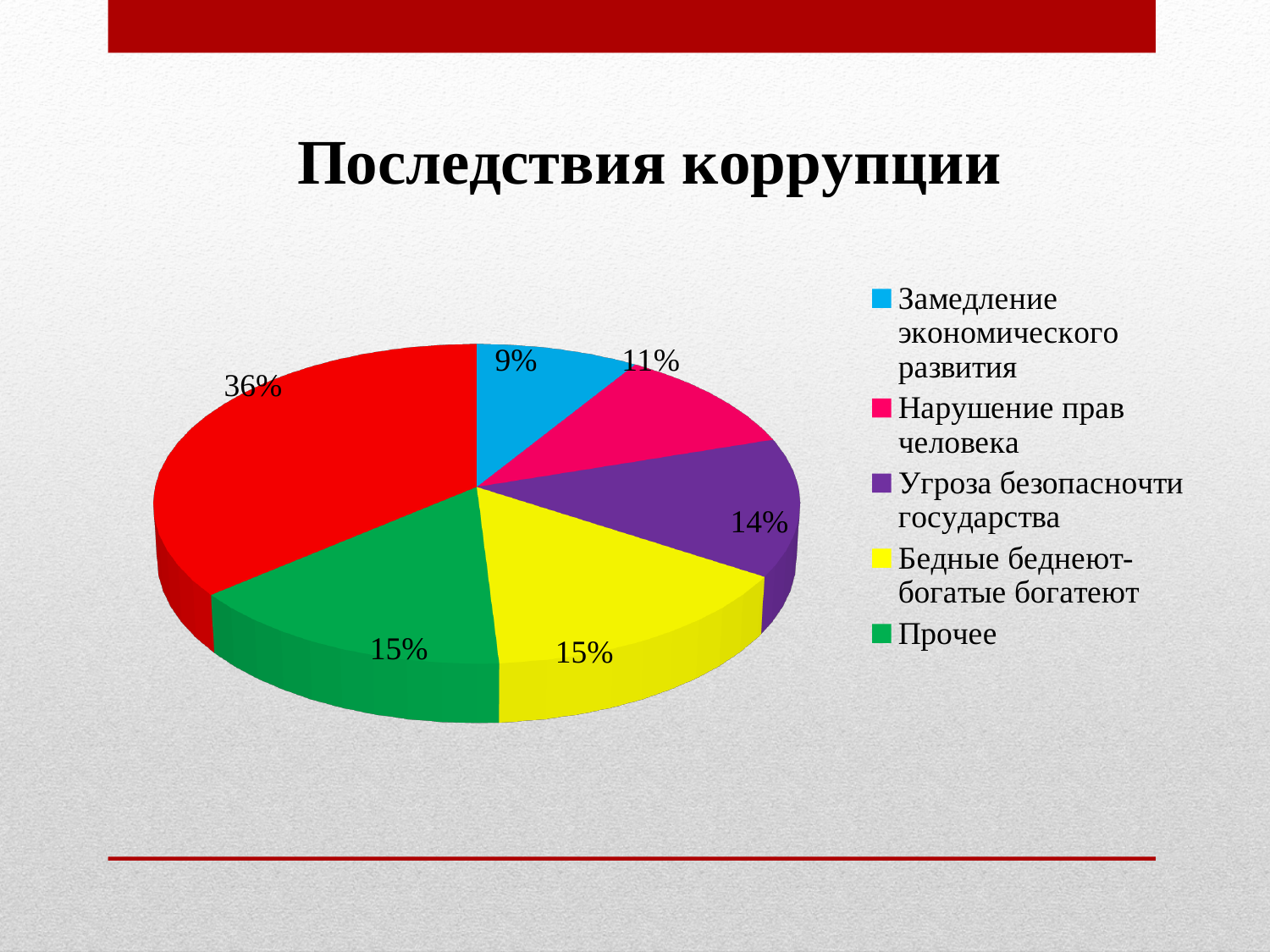
What share of the pie is labelled "Угроза безопасночти государства"? 14% How many entries does the legend list? 5 What share of the pie is labelled "Прочее"? 15% What kind of chart is shown on the slide? pie chart What is the largest percentage shown on the pie chart? 36% What share of the pie is labelled "Бедные беднеют-богатые богатеют"? 15% Which legend category has the smallest share of the pie? Замедление экономического развития How many slices does the pie chart have? 6 What share of the pie is labelled "Нарушение прав человека"? 11% What share of the pie is labelled "Замедление экономического развития"? 9% What is the difference between the shares for "Угроза безопасночти государства" and "Замедление экономического развития"? 5% Which is larger: the share for "Нарушение прав человека" or the share for "Прочее"? Прочее